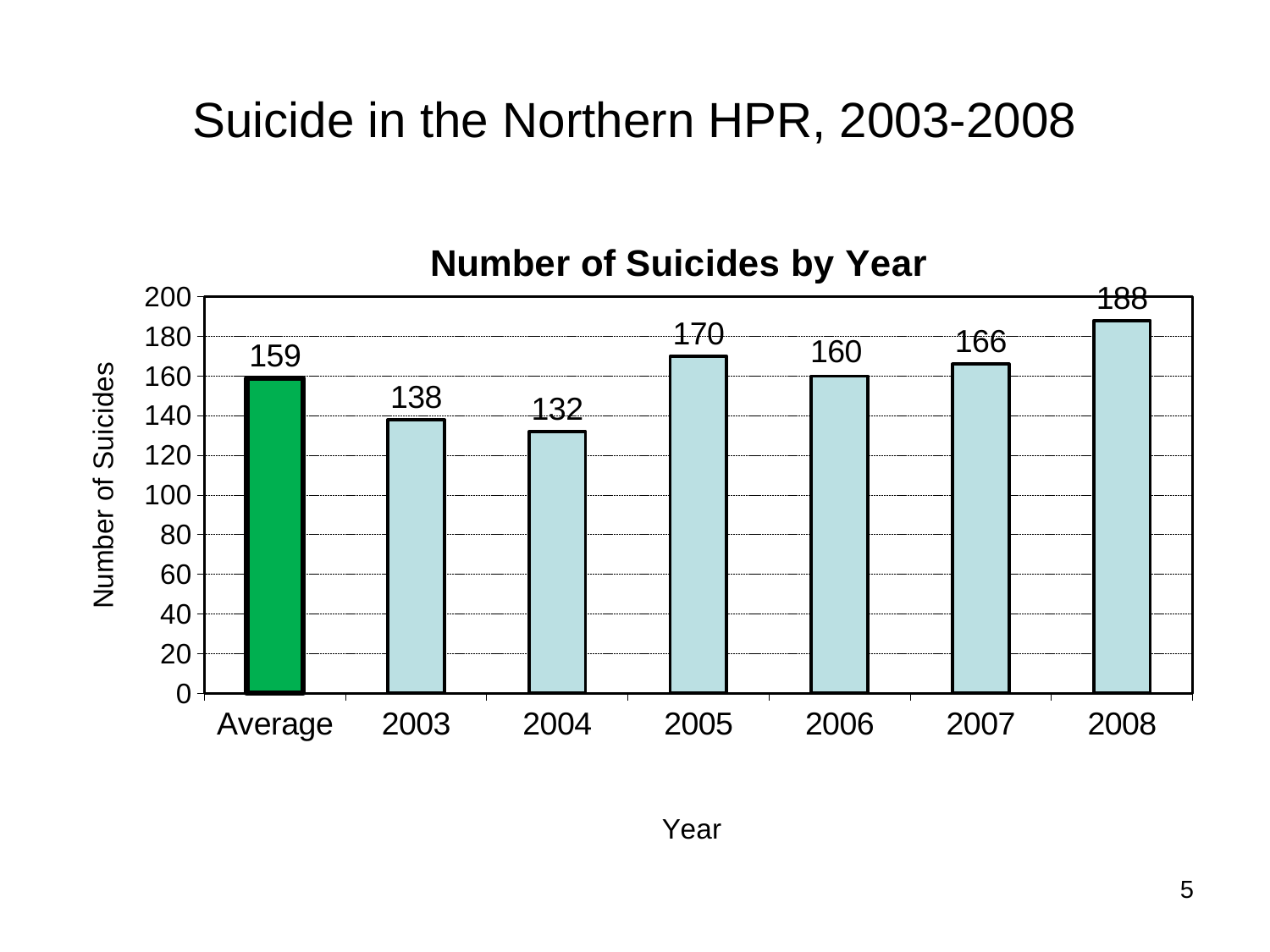
What is the title of the chart? Number of Suicides by Year What kind of chart is shown on the slide? Bar chart Which year has the highest number of suicides? 2008 What is the number of suicides shown for 2005? 170 Is the value for 2003 greater or less than 140? less Which year has the lowest number of suicides? 2004 What value is shown for the Average bar? 159 What is the number of suicides shown for 2004? 132 Do the values rise or fall from 2004 to 2005? Rise Which is larger, the value for 2006 or the value for 2007? 2007 How many bars are shown in the chart? 7 What is the difference between the number of suicides in 2008 and in 2003? 50